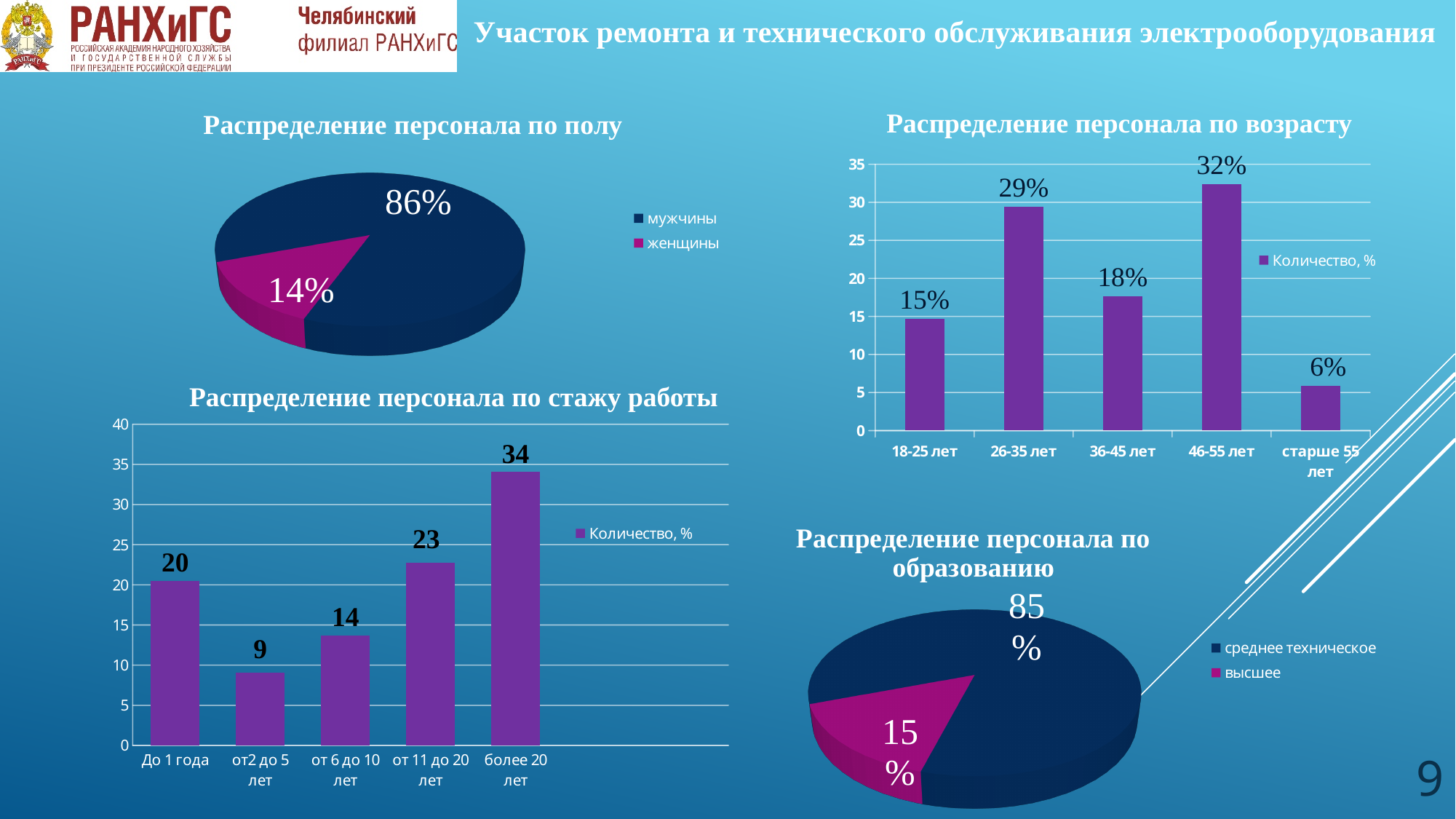
In the chart 'Распределение персонала по стажу работы', what kind of chart is used? bar chart In the chart 'Распределение персонала по полу', what share of the pie is 'мужчины'? 86% In the chart 'Распределение персонала по полу', what is the value for 'женщины'? 14% In the chart 'Распределение персонала по возрасту', which age group has the lowest value? старше 55 лет In the chart 'Распределение персонала по возрасту', how many age categories are shown? 5 In the chart 'Распределение персонала по образованию', what share of the pie is 'высшее'? 15% In the chart 'Распределение персонала по возрасту', what is the difference between '26-35 лет' and '18-25 лет'? 14% In the chart 'Распределение персонала по возрасту', what is the value for '46-55 лет'? 32% In the chart 'Распределение персонала по стажу работы', what is the value for 'от 11 до 20 лет'? 23 In the chart 'Распределение персонала по стажу работы', which category has the highest value? более 20 лет In the chart 'Распределение персонала по образованию', how many entries does the legend list? 2 In the chart 'Распределение персонала по стажу работы', which is larger: 'До 1 года' or 'от 6 до 10 лет'? До 1 года